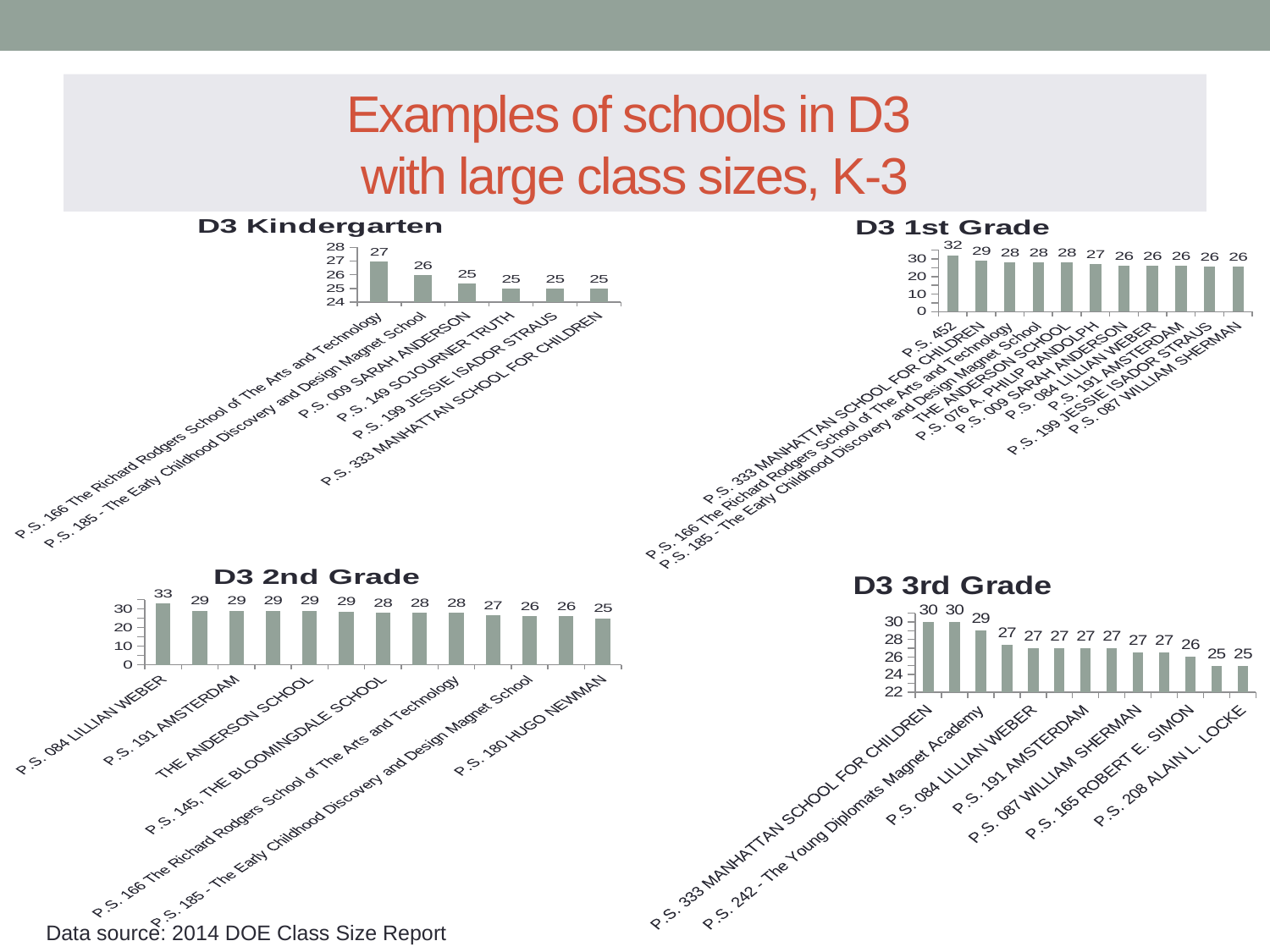
How many schools are shown in the D3 1st Grade chart? 11 In the D3 2nd Grade chart, which school has the lowest value? P.S. 180 Hugo Newman What type of chart is the D3 3rd Grade chart? bar chart How many schools are shown in the D3 Kindergarten chart? 6 In the D3 2nd Grade chart, do the values rise or fall from left to right? fall In the D3 2nd Grade chart, what is the value for P.S. 084 Lillian Weber? 33 In the D3 3rd Grade chart, what is the value for P.S. 208 Alain L. Locke? 25 In the D3 1st Grade chart, what is the value for P.S. 452? 32 In the D3 Kindergarten chart, what is the value for P.S. 166 The Richard Rodgers School of The Arts and Technology? 27 In the D3 3rd Grade chart, which is larger: the value for P.S. 333 Manhattan School for Children or the value for P.S. 208 Alain L. Locke? P.S. 333 Manhattan School for Children In the D3 Kindergarten chart, which school has the highest value? P.S. 166 The Richard Rodgers School of The Arts and Technology In the D3 1st Grade chart, what is the difference between the value for P.S. 452 and the value for P.S. 087 William Sherman? 6